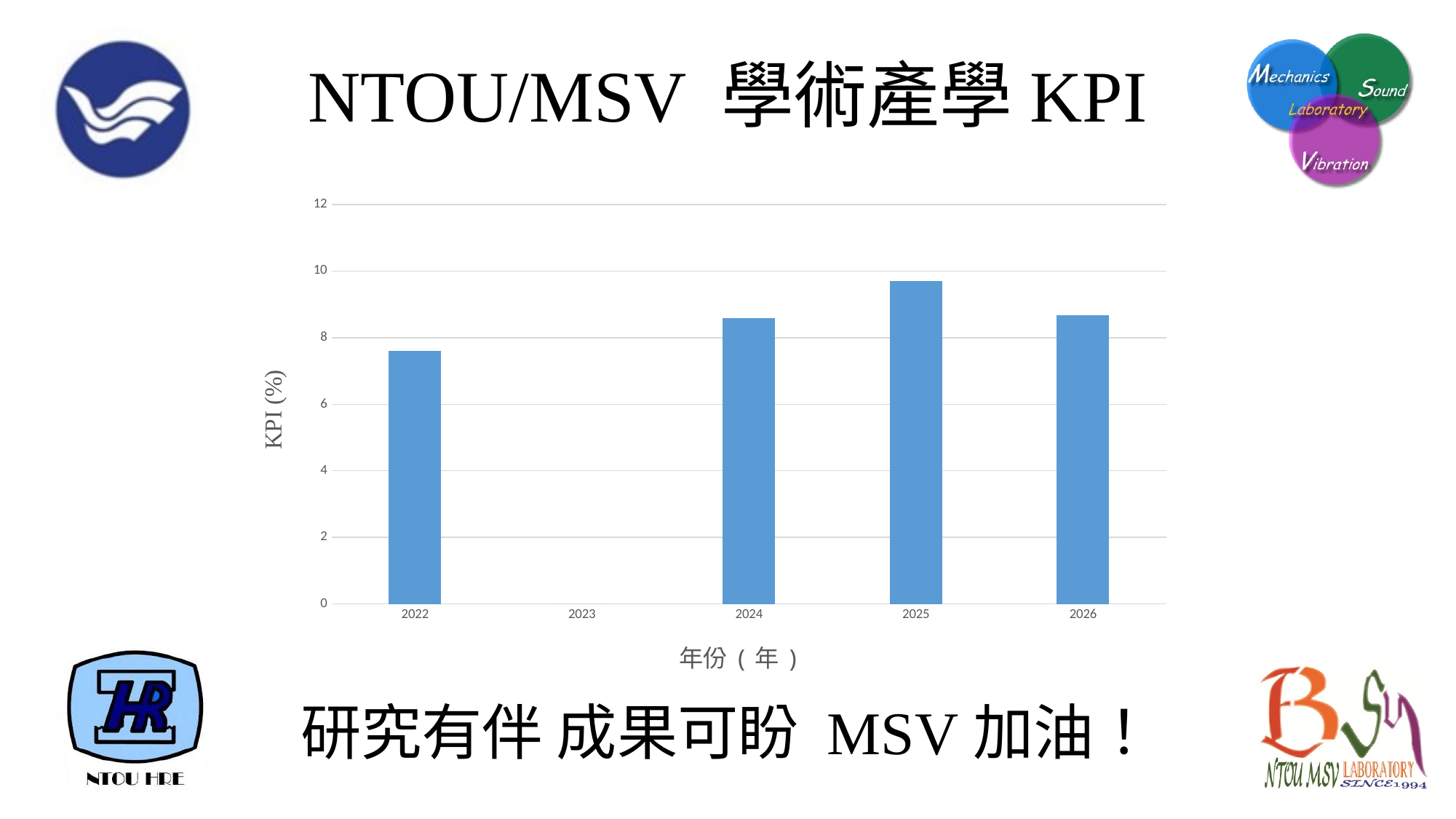
What is the label on the horizontal axis of the chart? 年份（年） What kind of chart is shown on the slide? bar chart How many years are listed along the x axis of the chart? 5 Is the KPI value for 2022 greater or less than 6? greater Which is larger, the KPI value for 2025 or for 2022? 2025 What is the label on the vertical axis of the chart? KPI (%) Which year has the highest KPI value in the chart? 2025 Which is larger, the KPI value for 2024 or for 2022? 2024 Is the KPI value for 2022 greater or less than 8? less Is the KPI value for 2025 greater or less than 10? less